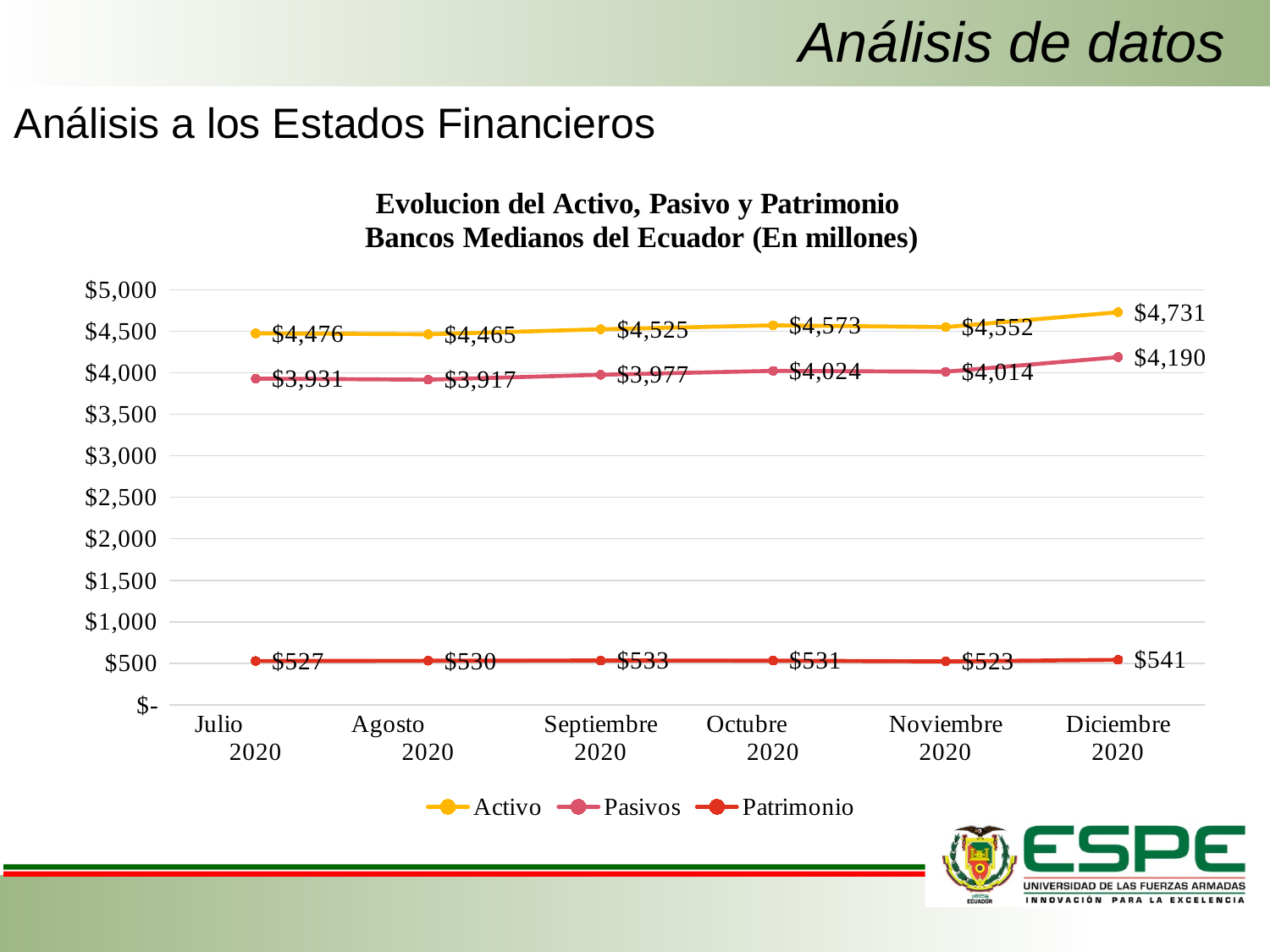
Which is larger, Pasivos in Julio 2020 or Pasivos in Agosto 2020? Julio 2020 What colour is the Activo line? Yellow What is the difference between Activo and Pasivos in Octubre 2020? $549 What is the value of Patrimonio in Noviembre 2020? $523 What kind of chart is this? Line chart Does Pasivos rise or fall from Noviembre 2020 to Diciembre 2020? Rise How many series does the legend list? 3 In which month is Activo lowest? Agosto 2020 What is the value of Activo in Diciembre 2020? $4,731 In which month is Patrimonio highest? Diciembre 2020 What is the value of Pasivos in Septiembre 2020? $3,977 How many months are shown on the x axis? 6